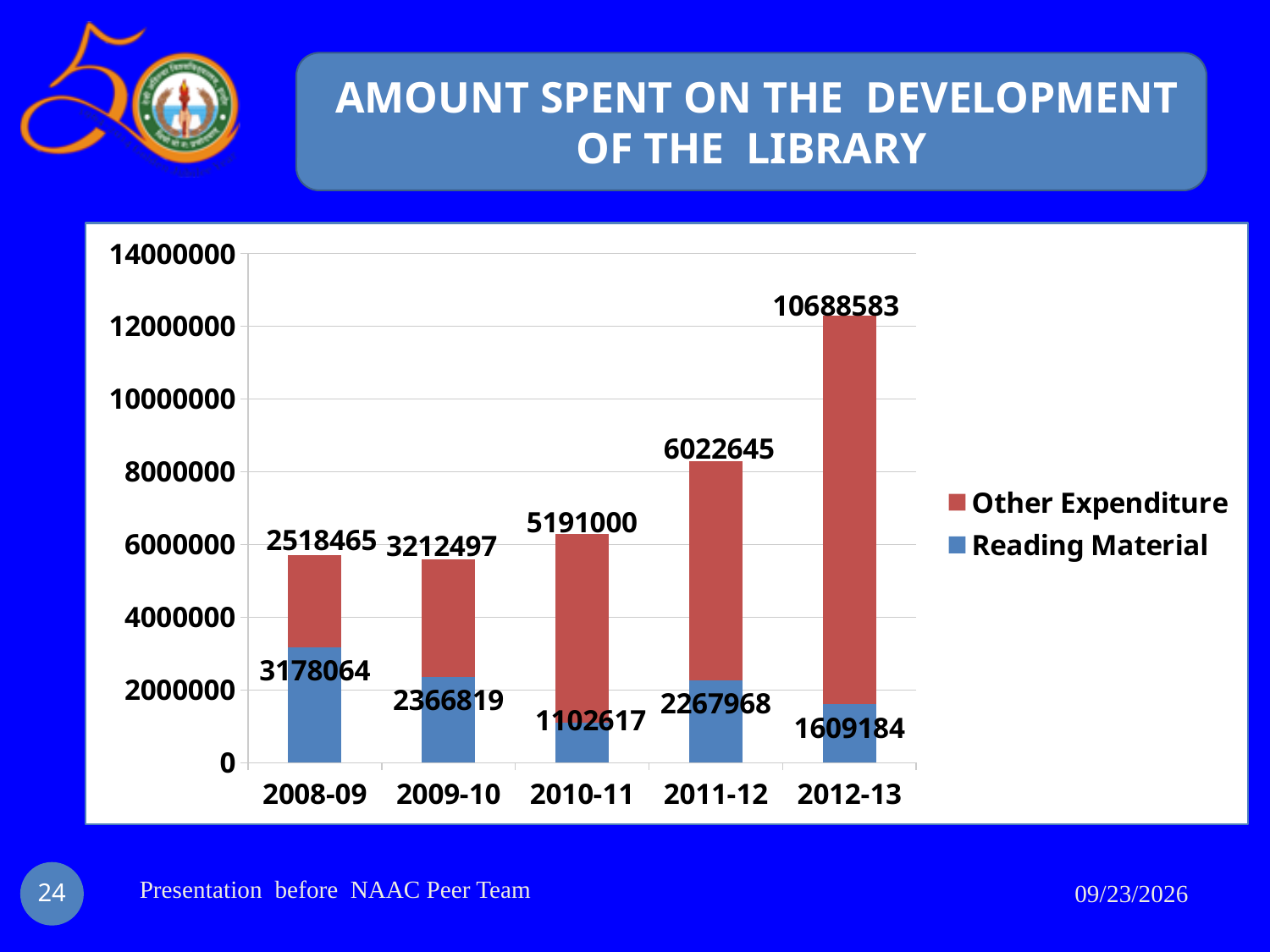
What is the difference between Other Expenditure in 2012-13 and 2011-12? 4665938 What is the Reading Material value for 2010-11? 1102617 Which is larger: Reading Material in 2008-09 or Reading Material in 2012-13? 2008-09 What is the Other Expenditure value for 2012-13? 10688583 Which year has the highest Other Expenditure? 2012-13 Does Other Expenditure rise or fall from 2008-09 to 2012-13? Rise How many year categories are shown on the x axis? 5 Which year has the lowest Reading Material value? 2010-11 How many series does the legend list? 2 What kind of chart is shown on the slide? Stacked bar chart What is the Other Expenditure value for 2009-10? 3212497 What is the total amount spent (both series) in 2011-12? 8290613